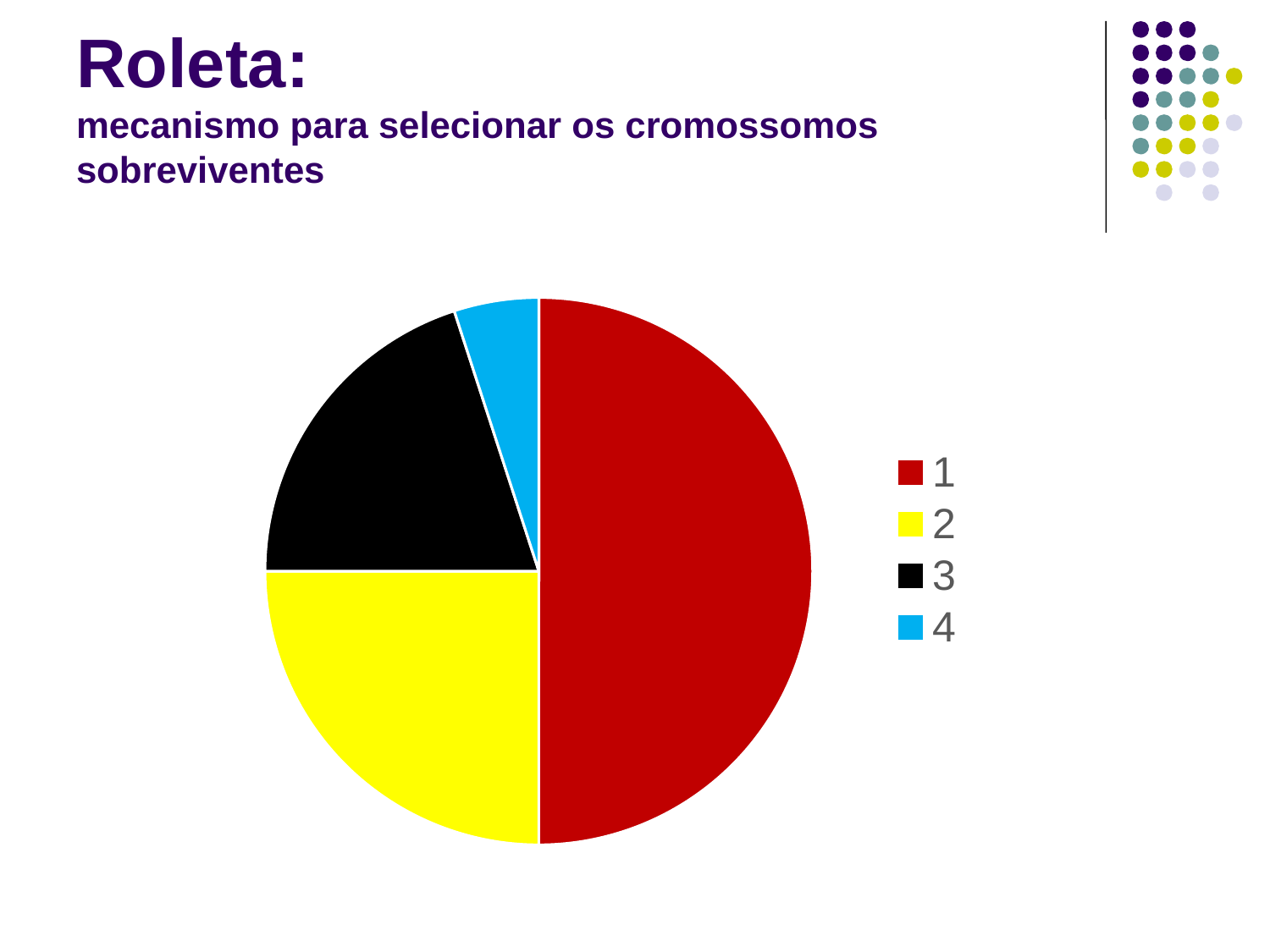
What kind of chart is shown on the slide? pie chart What colour is the slice for category 1 in the pie chart? red Which category has the largest slice in the pie chart? 1 How many slices does the pie chart have? 4 Which category has the smallest slice in the pie chart? 4 Which slice is larger in the pie chart, category 2 or category 3? 2 Which slice is larger in the pie chart, category 1 or category 4? 1 Which category is shown in yellow in the pie chart? 2 How many entries does the legend of the pie chart list? 4 Which slice is larger in the pie chart, category 3 or category 4? 3